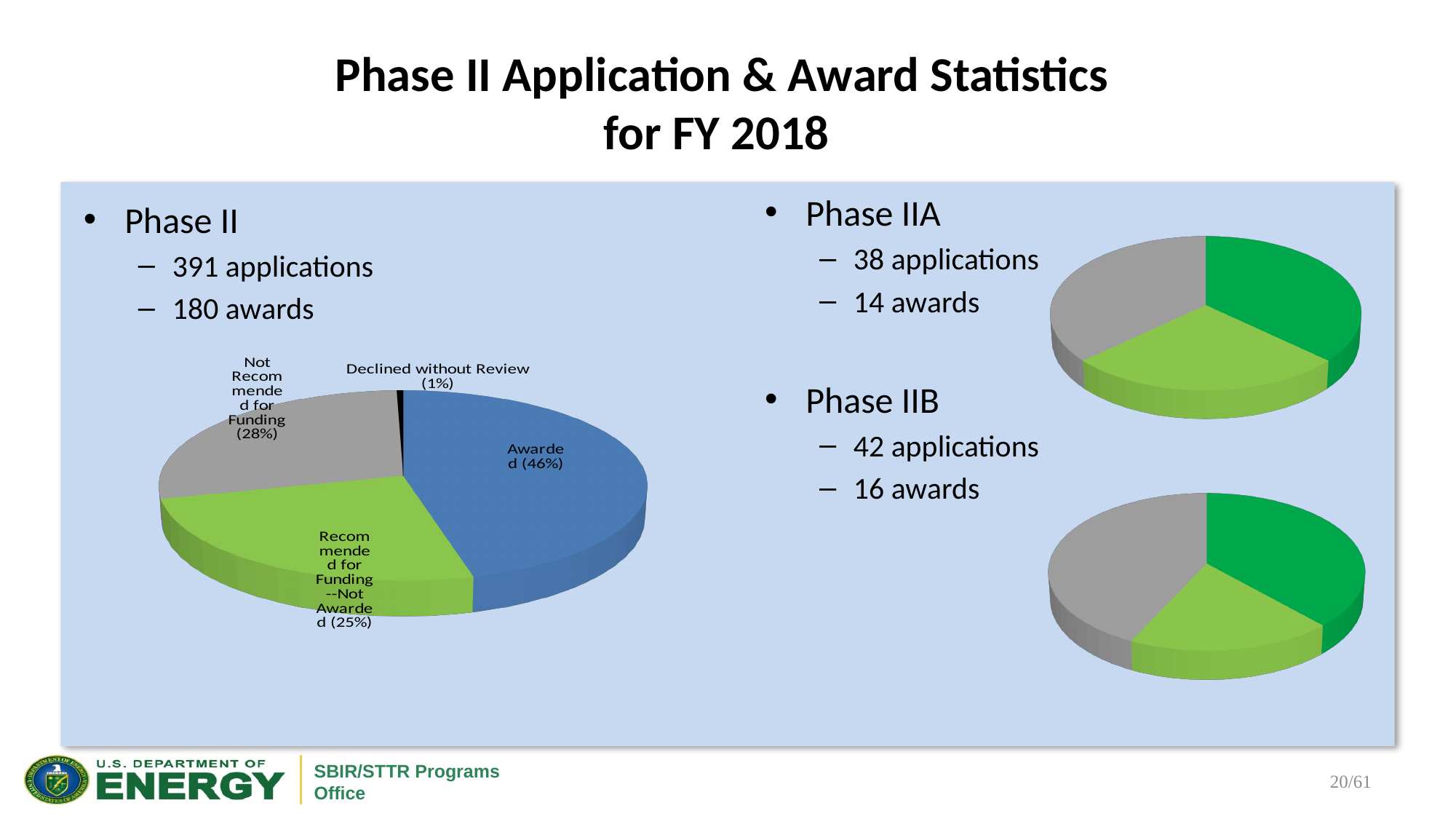
In the Phase II pie chart on the left, which is larger: Not Recommended for Funding or Recommended for Funding--Not Awarded? Not Recommended for Funding How many categories are shown in the Phase II pie chart on the left? 4 In the Phase II pie chart on the left, which category has the smallest share? Declined without Review In the Phase II pie chart on the left, how many percentage points larger is the Awarded share than the Not Recommended for Funding share? 18 In the Phase II pie chart on the left, what share of applications were Not Recommended for Funding? 28% What kind of chart is the Phase II chart on the left of the slide? Pie chart In the Phase II pie chart on the left, which category has the largest share? Awarded In the Phase II pie chart on the left, what share of applications were Declined without Review? 1% In the Phase II pie chart on the left, what share of applications were Recommended for Funding--Not Awarded? 25% How many pie charts are on the slide? 3 In the Phase II pie chart on the left, what colour is the Awarded slice? Blue In the Phase II pie chart on the left, what share of applications were Awarded? 46%